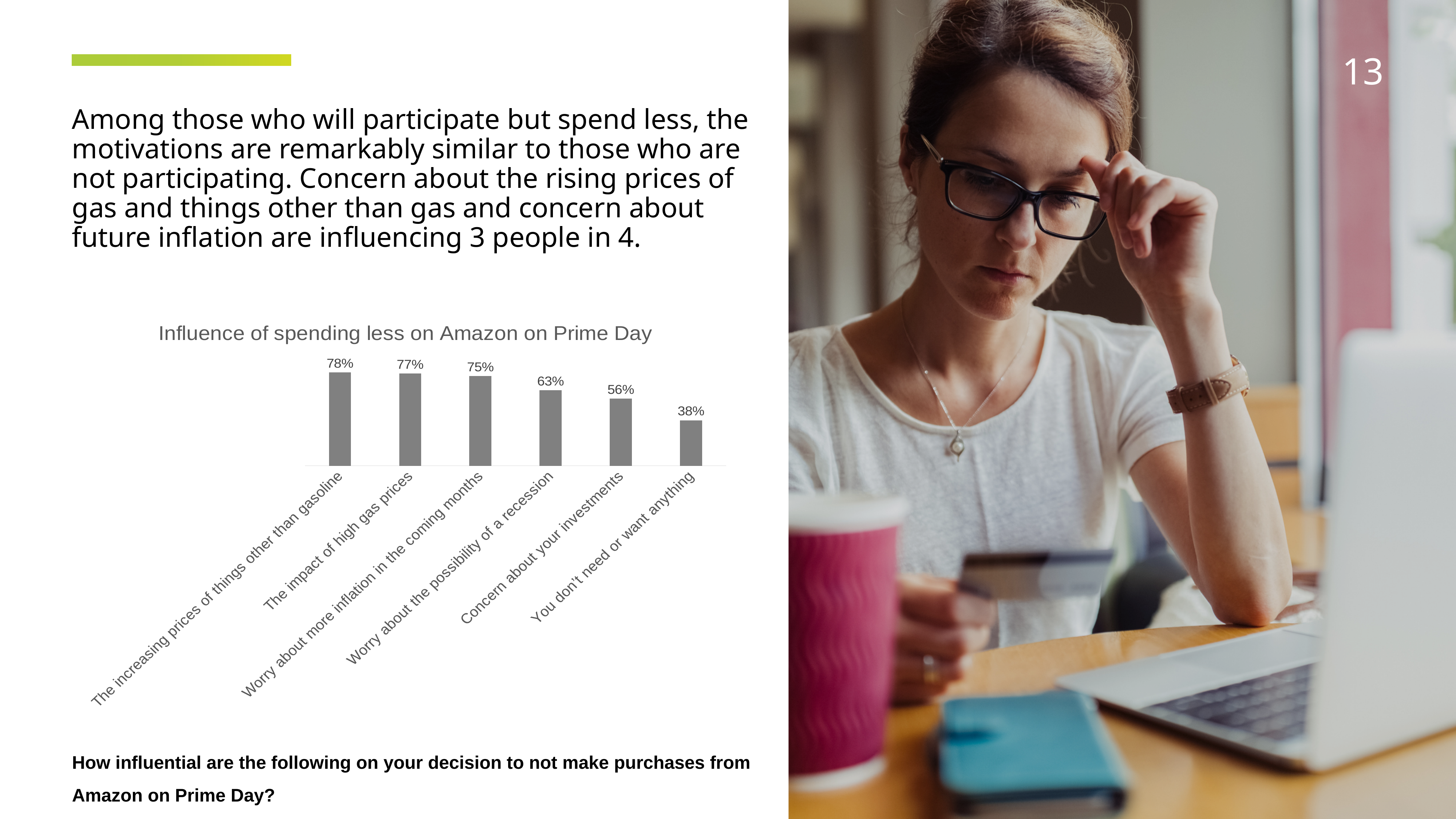
What is the value for 'Concern about your investments'? 56% What is the value for 'The impact of high gas prices'? 77% Which category has the lowest value? You don't need or want anything How many categories are shown in the chart? 6 What is the difference between 'The increasing prices of things other than gasoline' and 'You don't need or want anything'? 40% What is the title of the chart? Influence of spending less on Amazon on Prime Day What is the value for 'Worry about more inflation in the coming months'? 75% Which is larger: 'Worry about the possibility of a recession' or 'Concern about your investments'? Worry about the possibility of a recession What is the value for 'Worry about the possibility of a recession'? 63% What kind of chart is shown on the slide? Bar chart What is the value for 'The increasing prices of things other than gasoline'? 78% What is the value for 'You don't need or want anything'? 38%